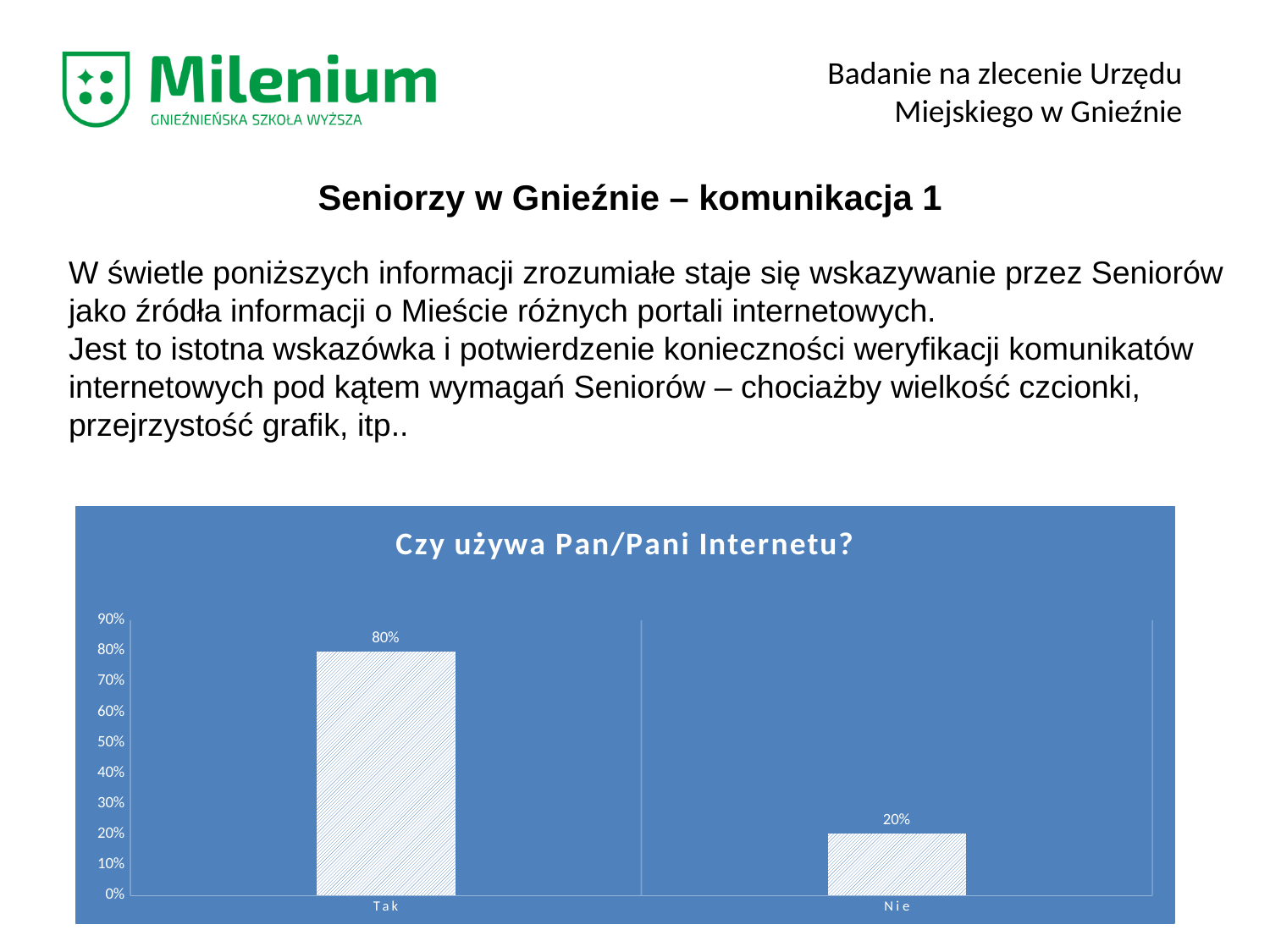
What is the value for "Tak" in the chart? 80% What kind of chart is shown on the slide? bar chart What is the highest value shown on the vertical axis of the chart? 90% Which is larger, the value for "Tak" or the value for "Nie"? Tak Is the value for "Tak" greater or less than 50%? greater What is the difference between the values for "Tak" and "Nie"? 60% Which category has the highest value in the chart? Tak What is the title of the chart? Czy używa Pan/Pani Internetu? Which category has the lowest value in the chart? Nie How many categories are shown in the chart? 2 What is the value for "Nie" in the chart? 20% Is the value for "Nie" greater or less than 30%? less